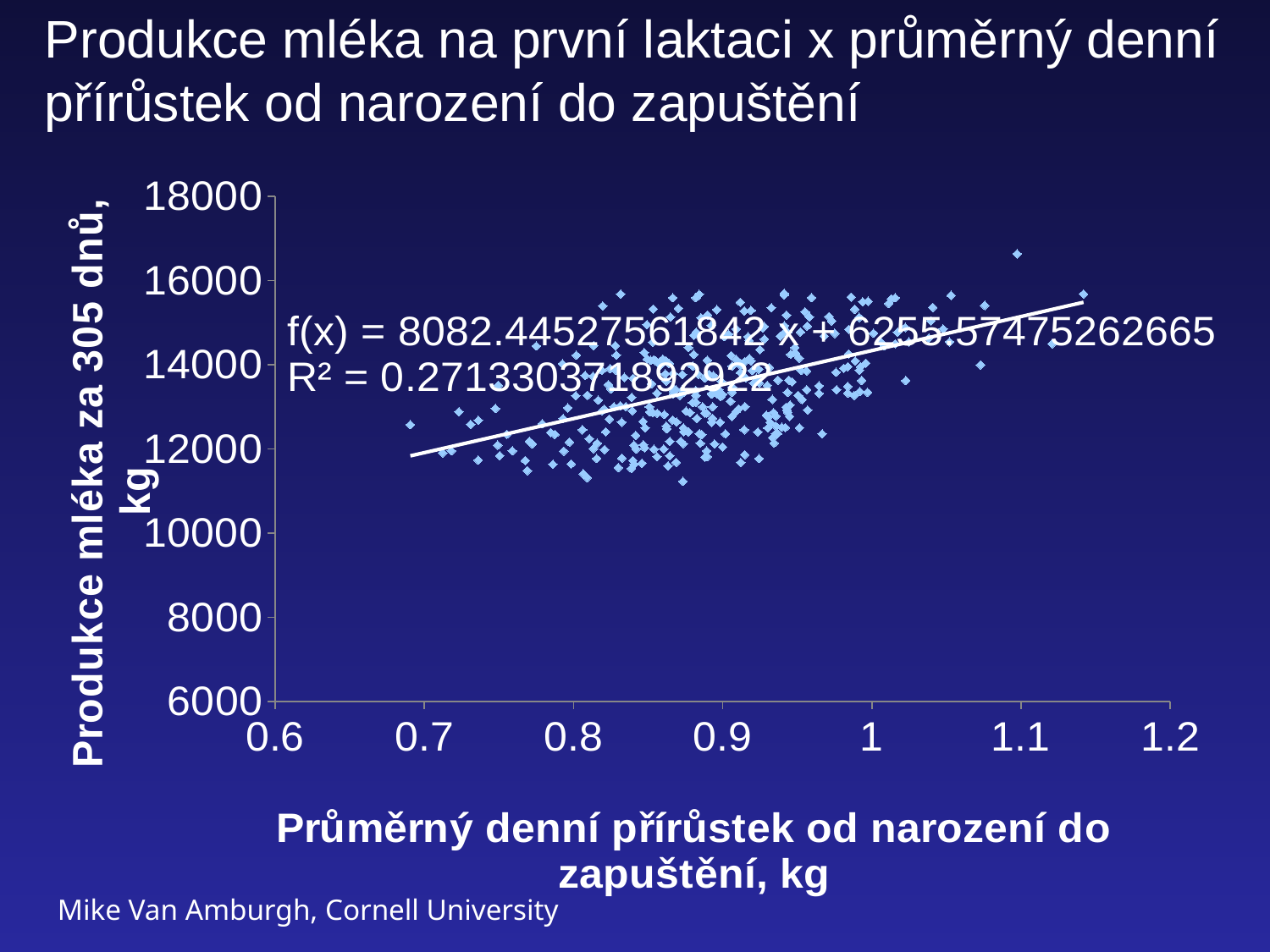
What is the slope coefficient of x in the fitted line equation f(x) shown on the chart? 8082.44527561842 Do the milk production values tend to rise or fall as the average daily gain increases along the x axis? Rise What is the label of the x axis? Průměrný denní přírůstek od narození do zapuštění, kg What is the lowest tick value shown on the y axis? 6000 Is the milk production value of the highest point on the chart greater or less than 16000? greater What kind of chart is shown on the slide? Scatter plot Is the milk production value of the lowest point on the chart greater or less than 12000? less Do any points on the chart fall below 10000 kg of milk production? No What is the label of the y axis? Produkce mléka za 305 dnů, kg What is the highest tick value shown on the x axis? 1.2